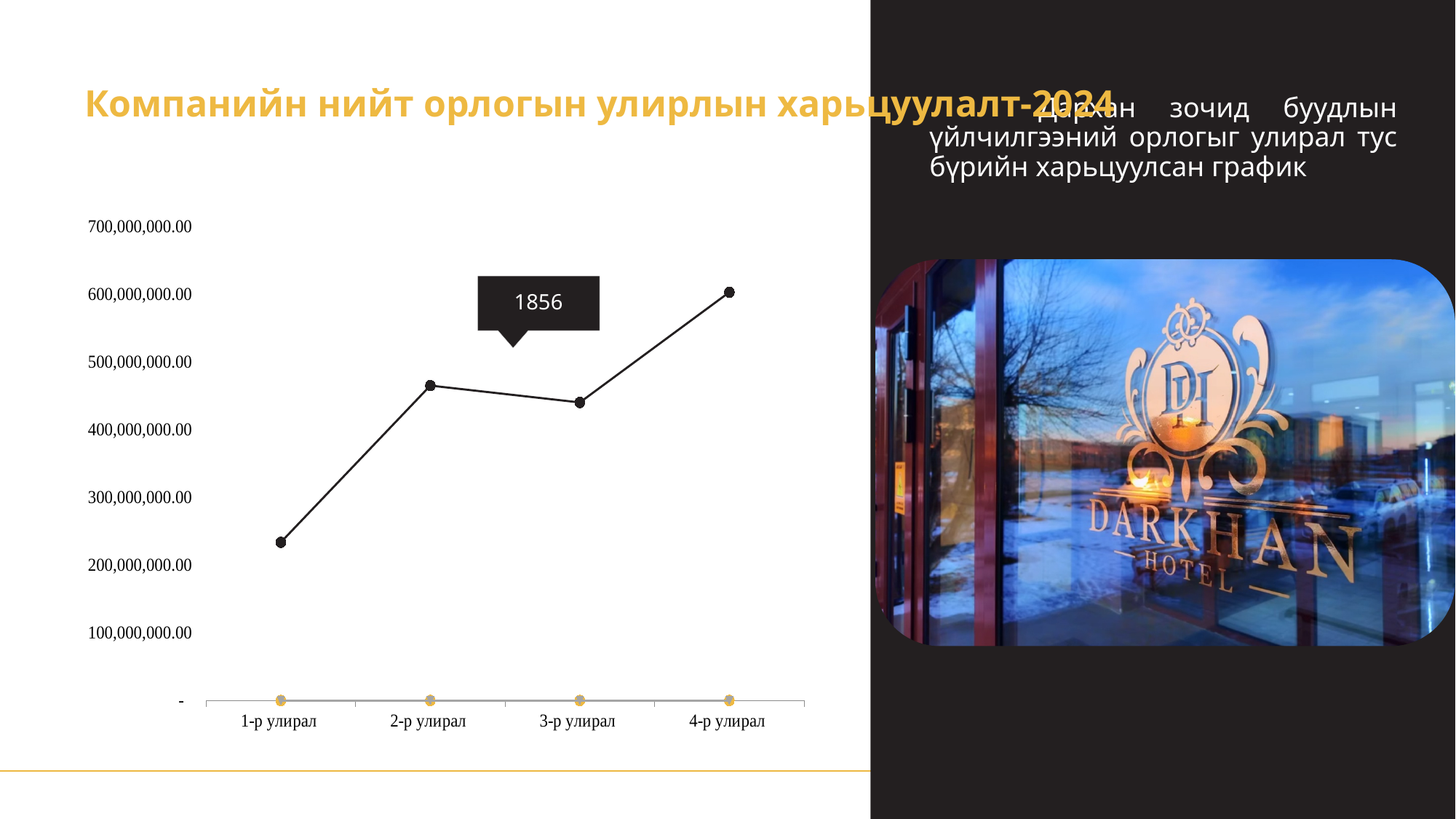
How many quarters (categories) are plotted on the x axis? 4 Is the value for 4-р улирал greater or less than 500,000,000.00? greater Which quarter has the lowest value? 1-р улирал Does the line generally rise or fall from 1-р улирал to 4-р улирал? rise Which quarter has the highest value? 4-р улирал Is the value for 3-р улирал greater or less than 500,000,000.00? less Is the value for 1-р улирал greater or less than 200,000,000.00? greater What kind of chart is shown on the slide? line chart What is the title of the chart on the slide? Компанийн нийт орлогын улирлын харьцуулалт-2024 Which is larger, the value for 2-р улирал or 3-р улирал? 2-р улирал